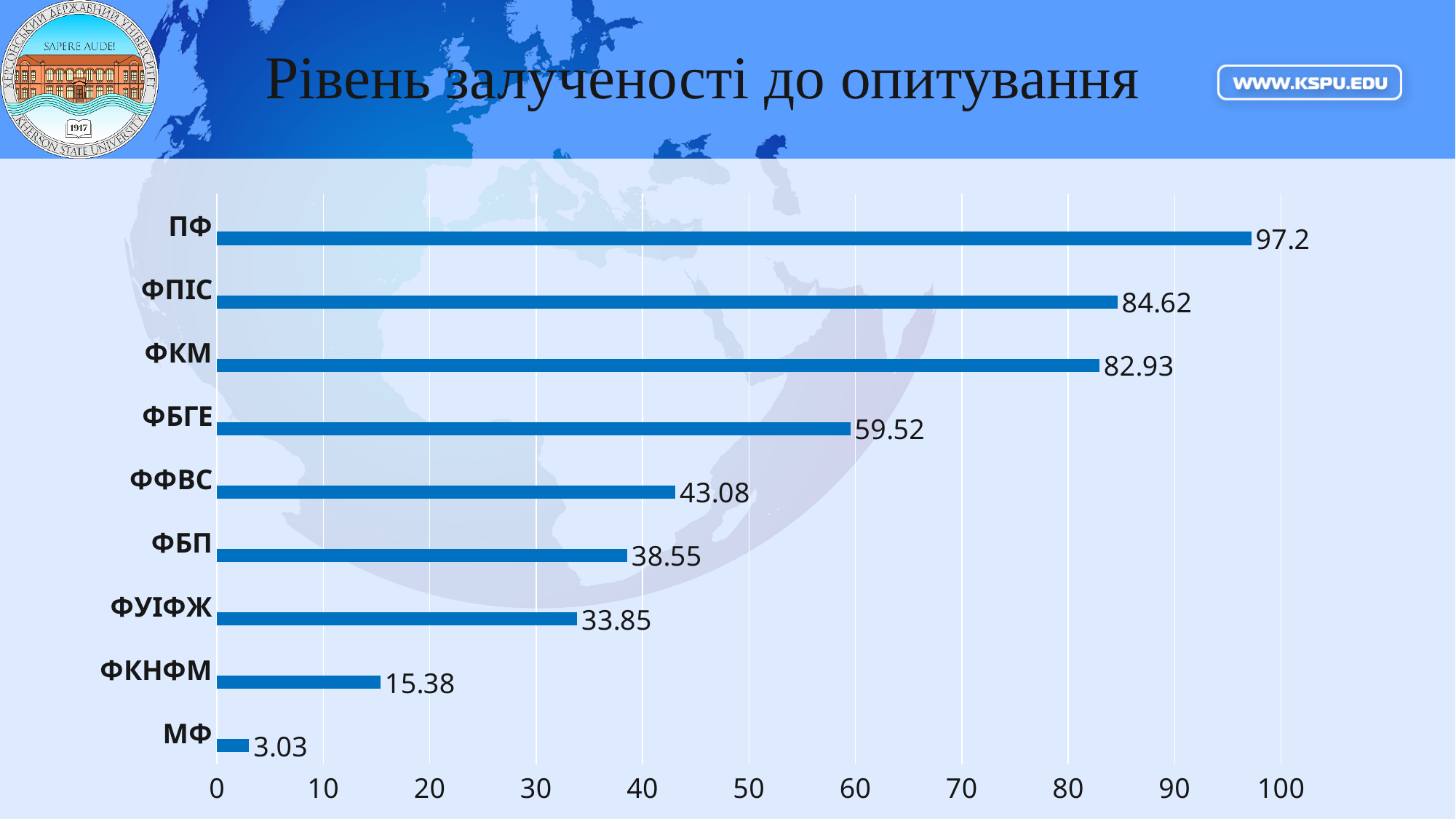
What is the value for ФКНФМ? 15.38 What kind of chart is shown on the slide? bar chart Which category has the lowest value? МФ What is the difference between the values for ПФ and МФ? 94.17 What is the value for ФБГЕ? 59.52 Is the value for ФУІФЖ greater or less than 40? less Which category has the highest value? ПФ What is the value for ПФ? 97.2 How many categories are shown in the chart? 9 What is the title of the chart? Рівень залученості до опитування Which is larger, the value for ФФВС or the value for ФБП? ФФВС What is the difference between the values for ФПІС and ФКМ? 1.69